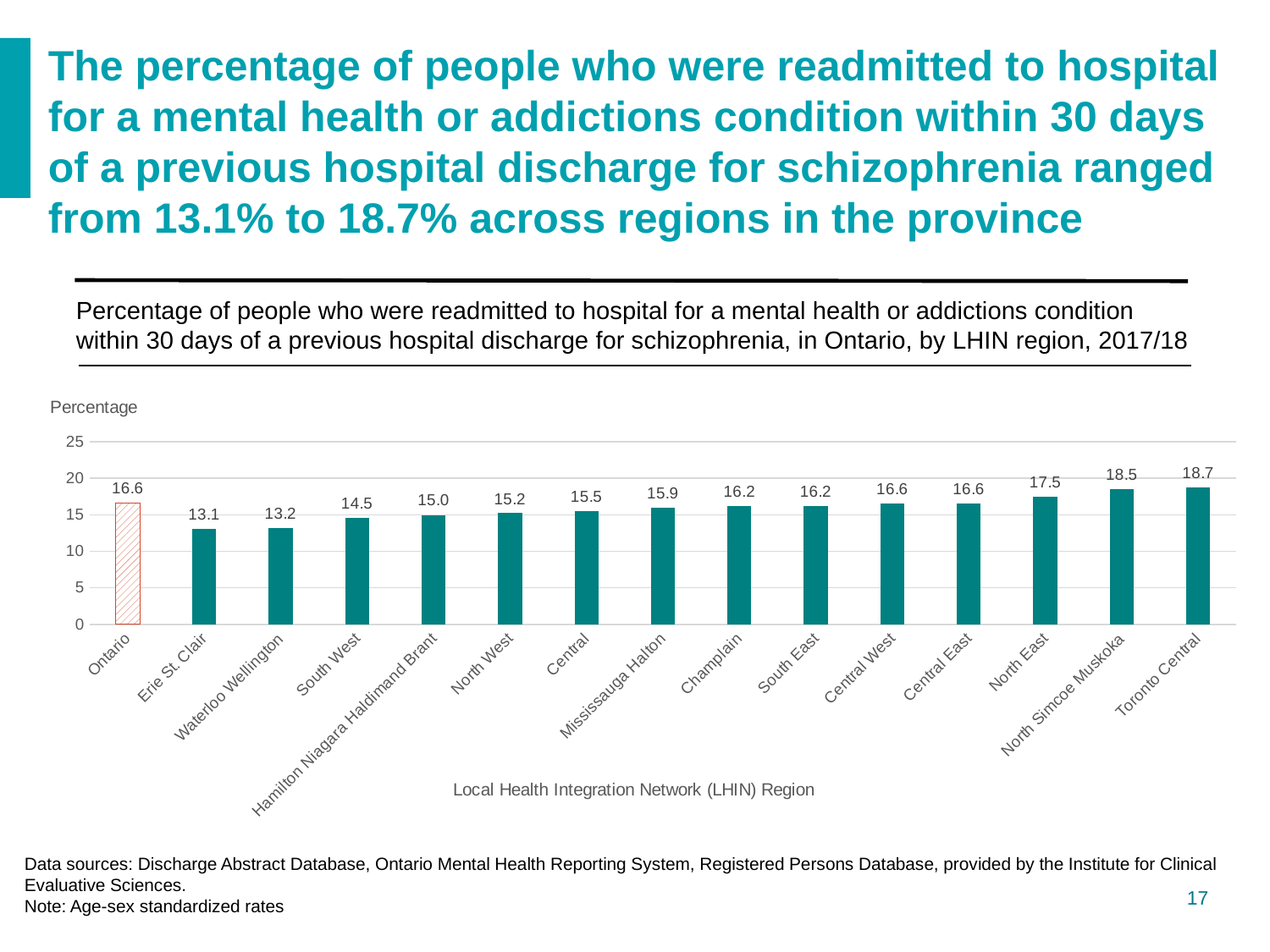
Is the value for Waterloo Wellington greater or less than 15? less How many bars are shown in the chart? 15 What is the value for Erie St. Clair? 13.1 What is the difference between the values for Toronto Central and Erie St. Clair? 5.6 What is the value for Ontario? 16.6 Which LHIN region has the lowest value? Erie St. Clair What is the label of the x axis? Local Health Integration Network (LHIN) Region Which LHIN region has the highest value? Toronto Central What is the value for Hamilton Niagara Haldimand Brant? 15.0 Which is larger, the value for North East or the value for Champlain? North East What is the value for Toronto Central? 18.7 What kind of chart is shown on the slide? bar chart